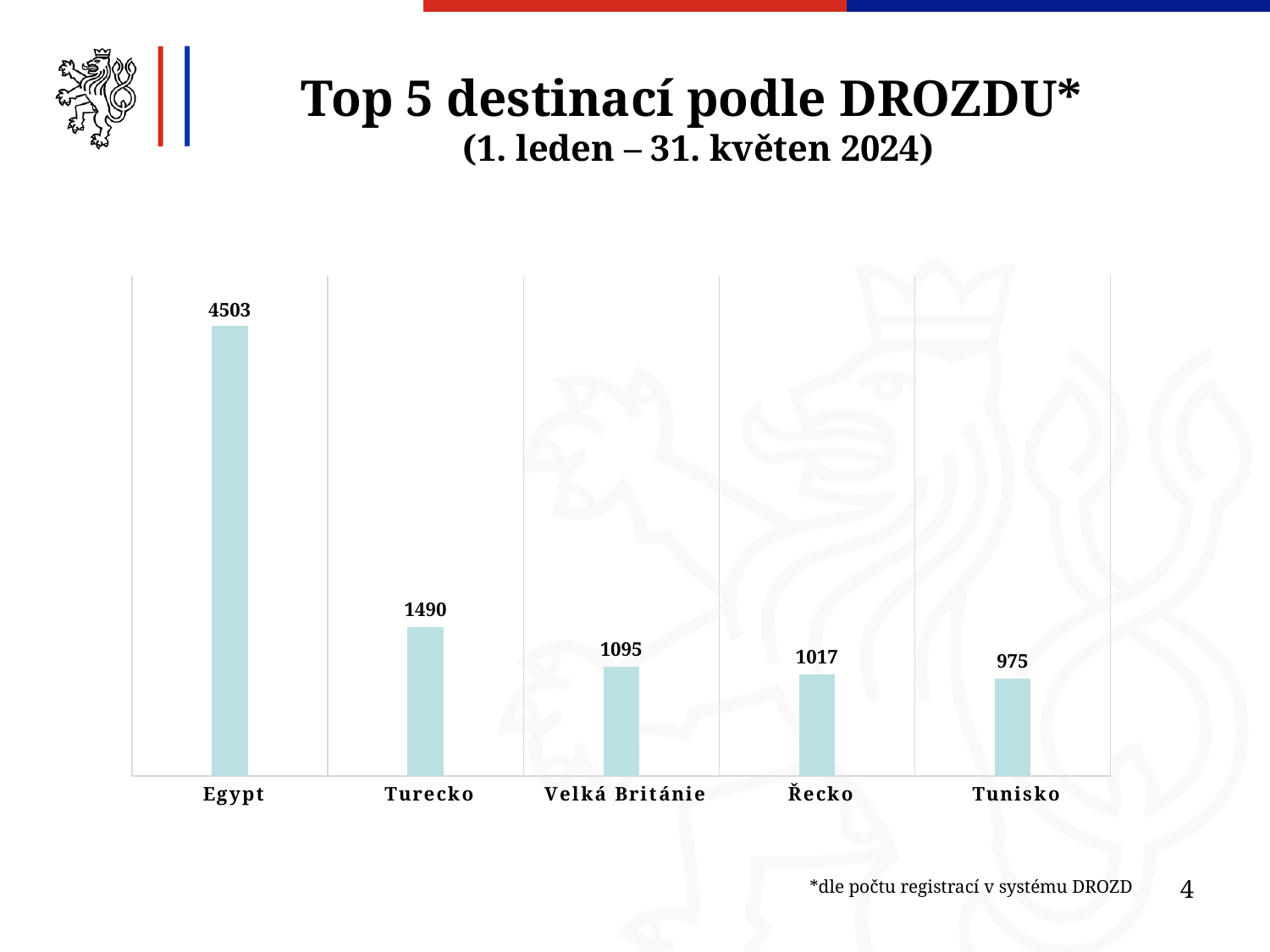
Which is larger, the value for Turecko or the value for Velká Británie? Turecko Which destination has the highest value? Egypt What is the value for Řecko? 1017 What kind of chart is shown on the slide? Bar chart How many destinations are shown in the chart? 5 What is the difference between the values for Egypt and Turecko? 3013 Which destination has the lowest value? Tunisko What is the difference between the values for Řecko and Tunisko? 42 What is the value for Turecko? 1490 What is the value for Egypt? 4503 What is the value for Velká Británie? 1095 What is the value for Tunisko? 975